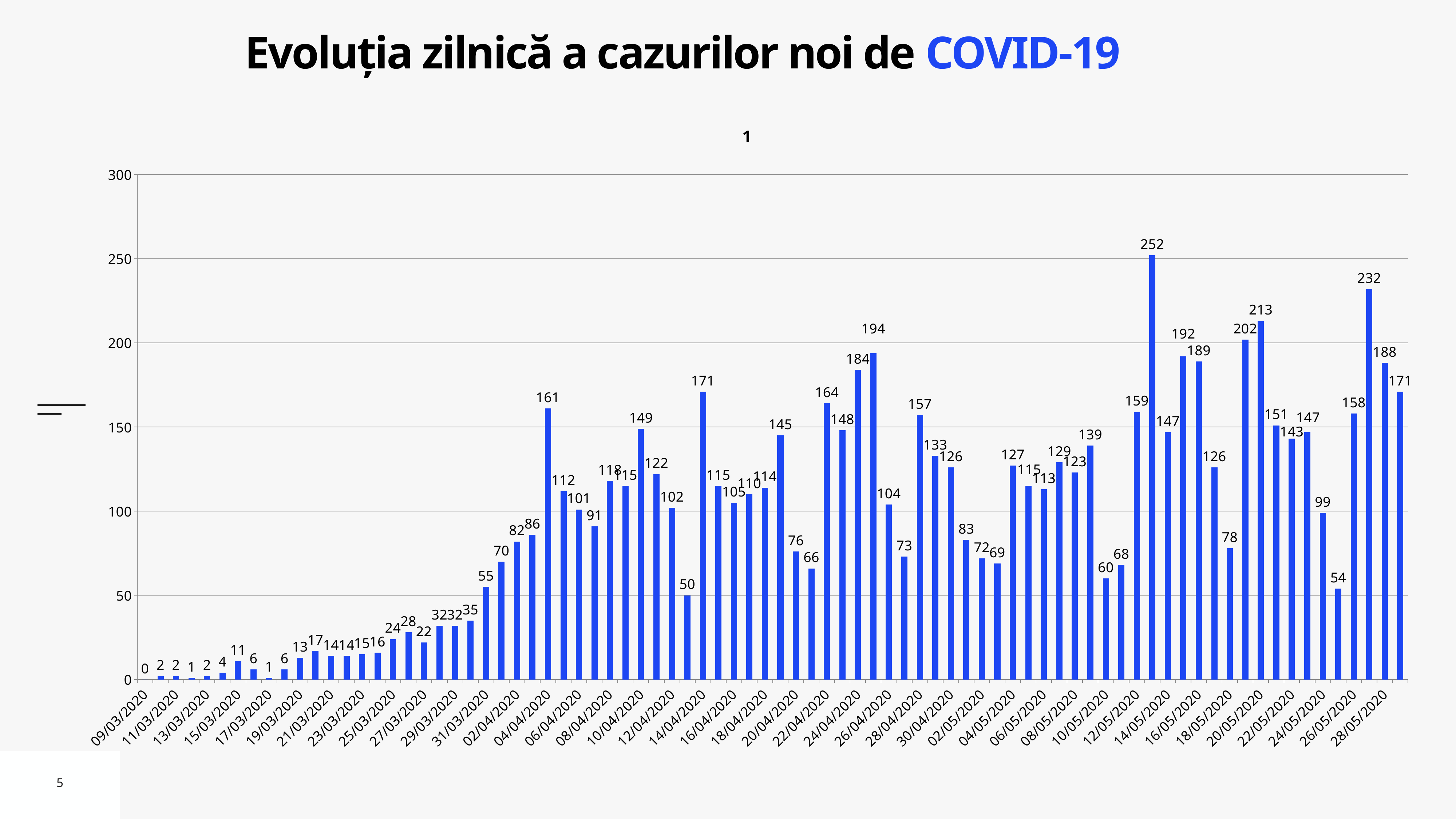
What kind of chart is shown on the slide? bar chart What is the value for 20/05/2020? 213 What is the highest daily value shown in the chart? 252 What is the difference between the values for 20/05/2020 and 28/05/2020? 25 What is the value for 10/05/2020? 60 What is the value for 14/04/2020? 171 What is the value for 28/05/2020? 188 Overall, do the values rise or fall from March to May along the x axis? rise What is the value for 04/04/2020? 161 Is the value for 31/03/2020 greater or less than 50? greater On which date is the lowest value (0) recorded? 09/03/2020 Which is larger, the value for 24/04/2020 or the value for 28/04/2020? 24/04/2020